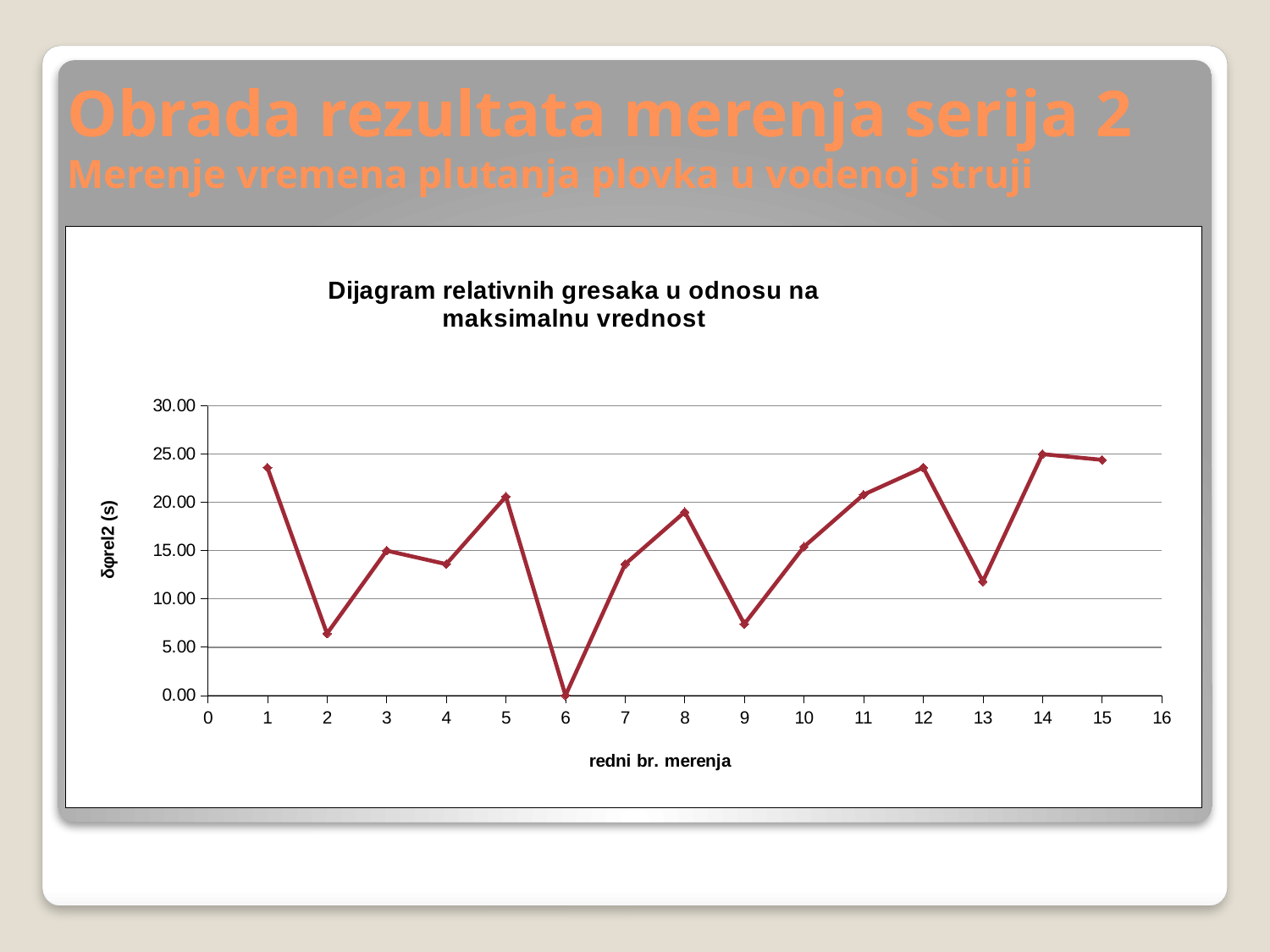
Do the values rise or fall from measurement 9 to measurement 12? rise Is the value for measurement 12 greater or less than 20.00? greater Which has the larger value, measurement 6 or measurement 7? measurement 7 Which has the larger value, measurement 12 or measurement 13? measurement 12 How many measurement points are plotted on the chart? 15 Is the value for measurement 9 greater or less than 10.00? less What is the value for measurement number 6? 0.00 Which measurement number has the lowest value? 6 What kind of chart is shown on the slide? line chart Is the value for measurement 1 greater or less than 20.00? greater What is the label of the x axis? redni br. merenja